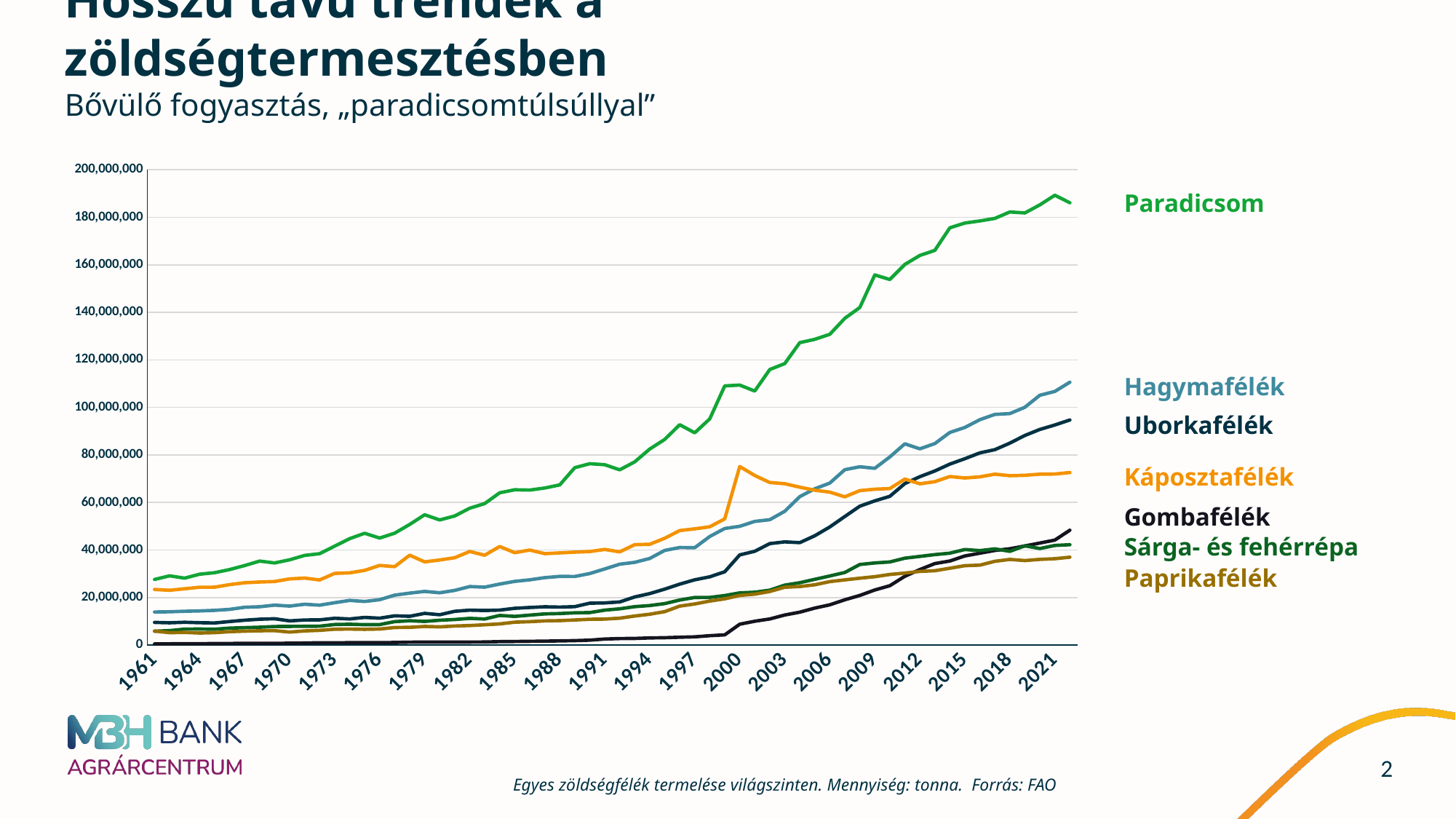
Is the value for Uborkafélék in 2021 greater or less than 100,000,000? less Is the value for Hagymafélék in 2021 greater or less than 100,000,000? greater Is the value for Paradicsom in 1961 greater or less than 20,000,000? greater What kind of chart is shown on the slide? line chart Which series has the highest value at the right end of the chart (2021)? Paradicsom How many series are labelled on the chart? 7 How many year labels are shown on the x axis? 21 Which is larger in 2021, Hagymafélék or Uborkafélék? Hagymafélék Does the Paradicsom series rise or fall from 1961 to 2021? rise Which series has the lowest value at the right end of the chart (2021)? Paprikafélék According to the note under the chart, what is the source of the data? FAO